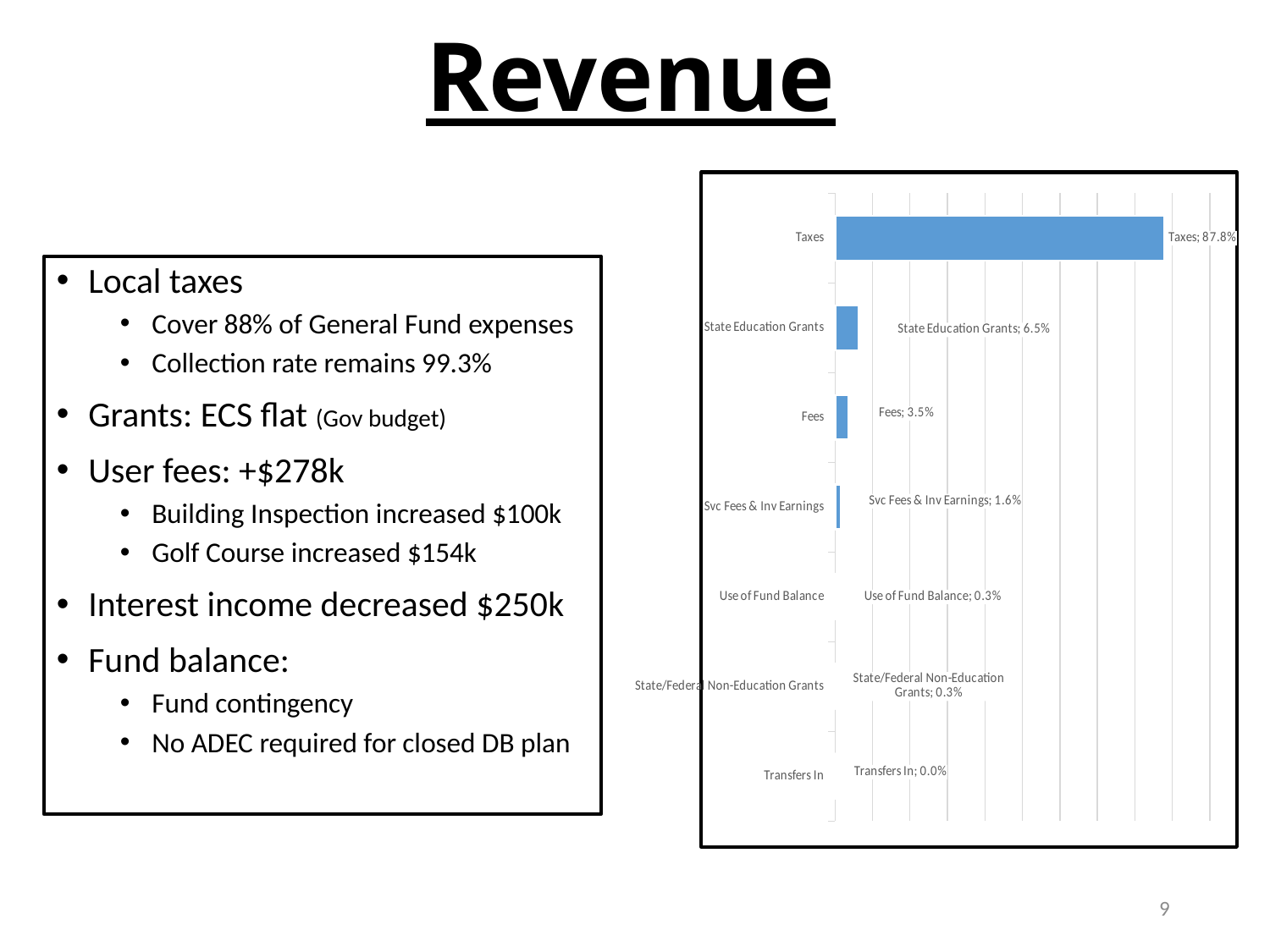
What is the value for Svc Fees & Inv Earnings? 1.6% What is the value for State Education Grants? 6.5% What kind of chart is shown on the slide? Bar chart Which is larger, the value for State Education Grants or the value for Fees? State Education Grants What is the value for Fees? 3.5% What is the difference between the values for Fees and Svc Fees & Inv Earnings? 1.9% Which category has the highest value? Taxes Which category has the lowest value? Transfers In What is the difference between the values for Taxes and State Education Grants? 81.3% What is the value for Taxes? 87.8% How many categories are shown in the chart? 7 What is the value for Transfers In? 0.0%